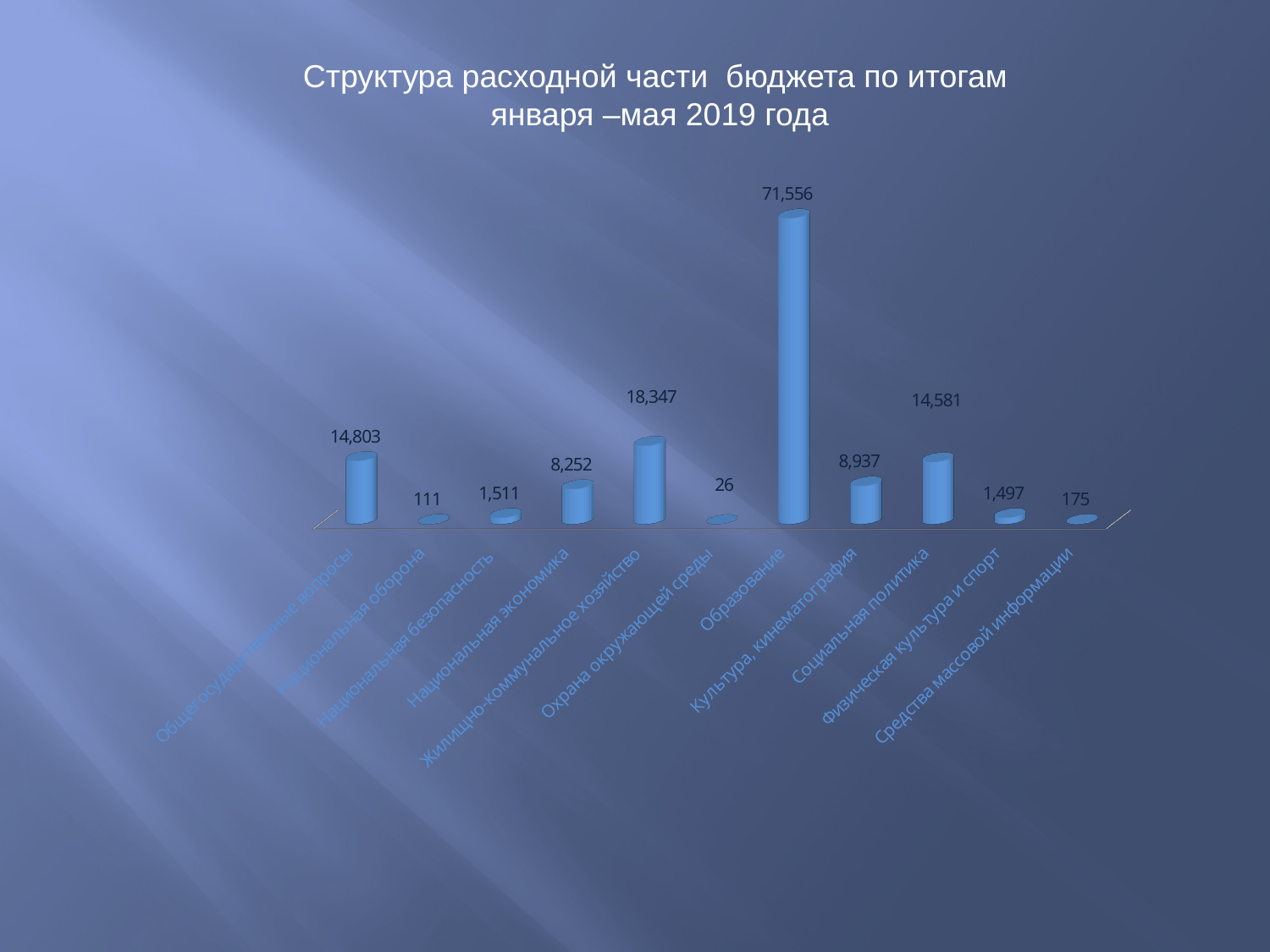
What is the difference between the values for Общегосударственные вопросы and Социальная политика? 222 What is the value for Образование? 71,556 What is the value for Жилищно-коммунальное хозяйство? 18,347 Which category has the highest value? Образование Which is larger, the value for Культура, кинематография or the value for Национальная экономика? Культура, кинематография What kind of chart is shown on the slide? Bar chart What is the title of the chart? Структура расходной части бюджета по итогам января –мая 2019 года How many categories are shown in the chart? 11 What is the value for Национальная оборона? 111 What is the value for Социальная политика? 14,581 Which category has the lowest value? Охрана окружающей среды What is the difference between the values for Образование and Жилищно-коммунальное хозяйство? 53,209